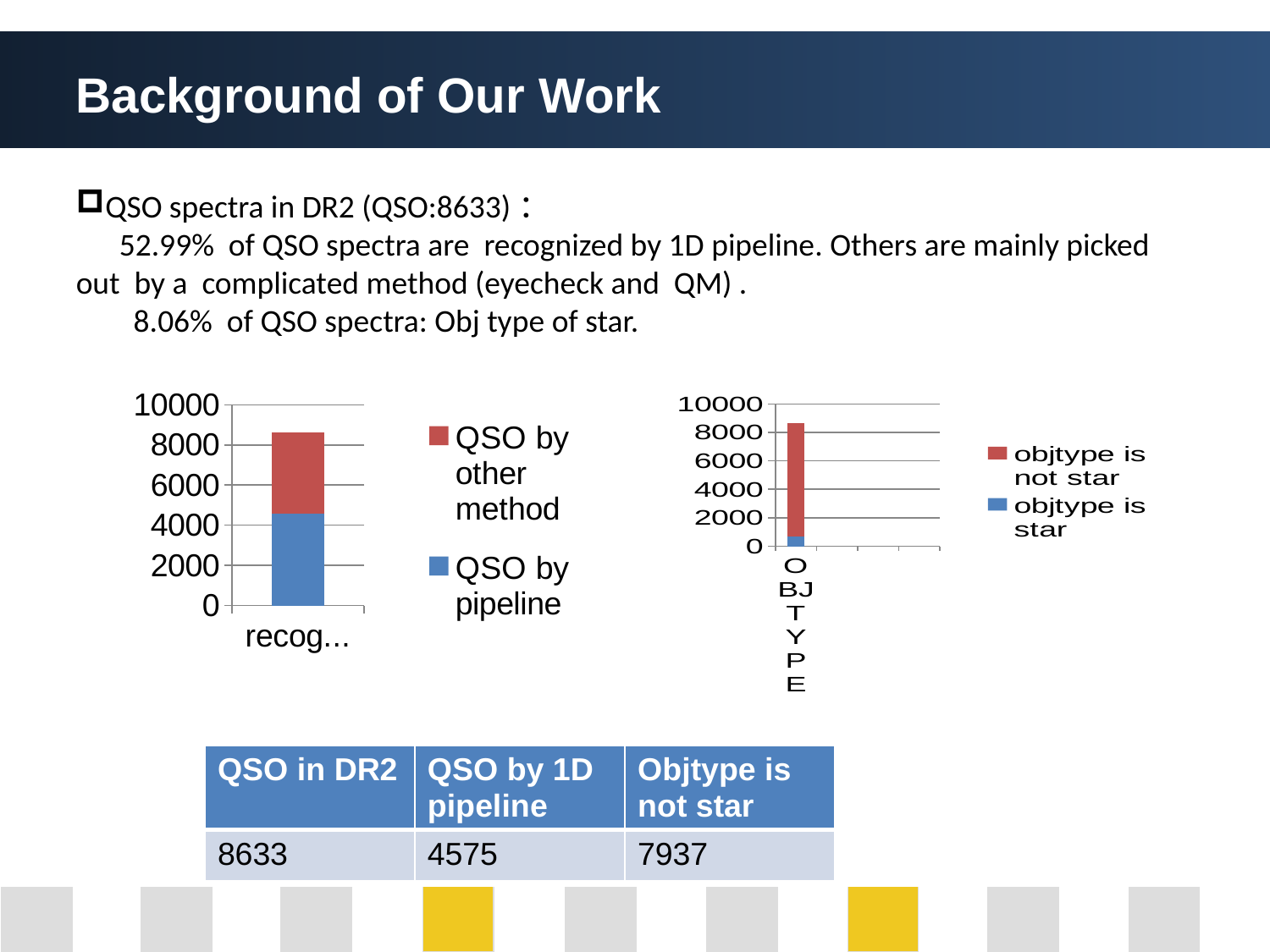
What kind of chart is the left chart (with legend 'QSO by pipeline')? bar chart In the right chart, what colour represents 'objtype is star'? blue How many series does the legend of the right chart list? 2 What kind of chart is the right chart (with category 'OBJTYPE')? bar chart In the left chart, is the top of the stacked bar greater or less than 8000? greater In the right chart, is the top of the stacked bar greater or less than 8000? greater In the right chart, is the value for 'objtype is star' greater or less than 2000? less In the right chart, which is larger: 'objtype is star' or 'objtype is not star'? objtype is not star How many bars are plotted in the left chart? 1 How many series does the legend of the left chart list? 2 What are the two legend entries of the left chart? QSO by other method; QSO by pipeline